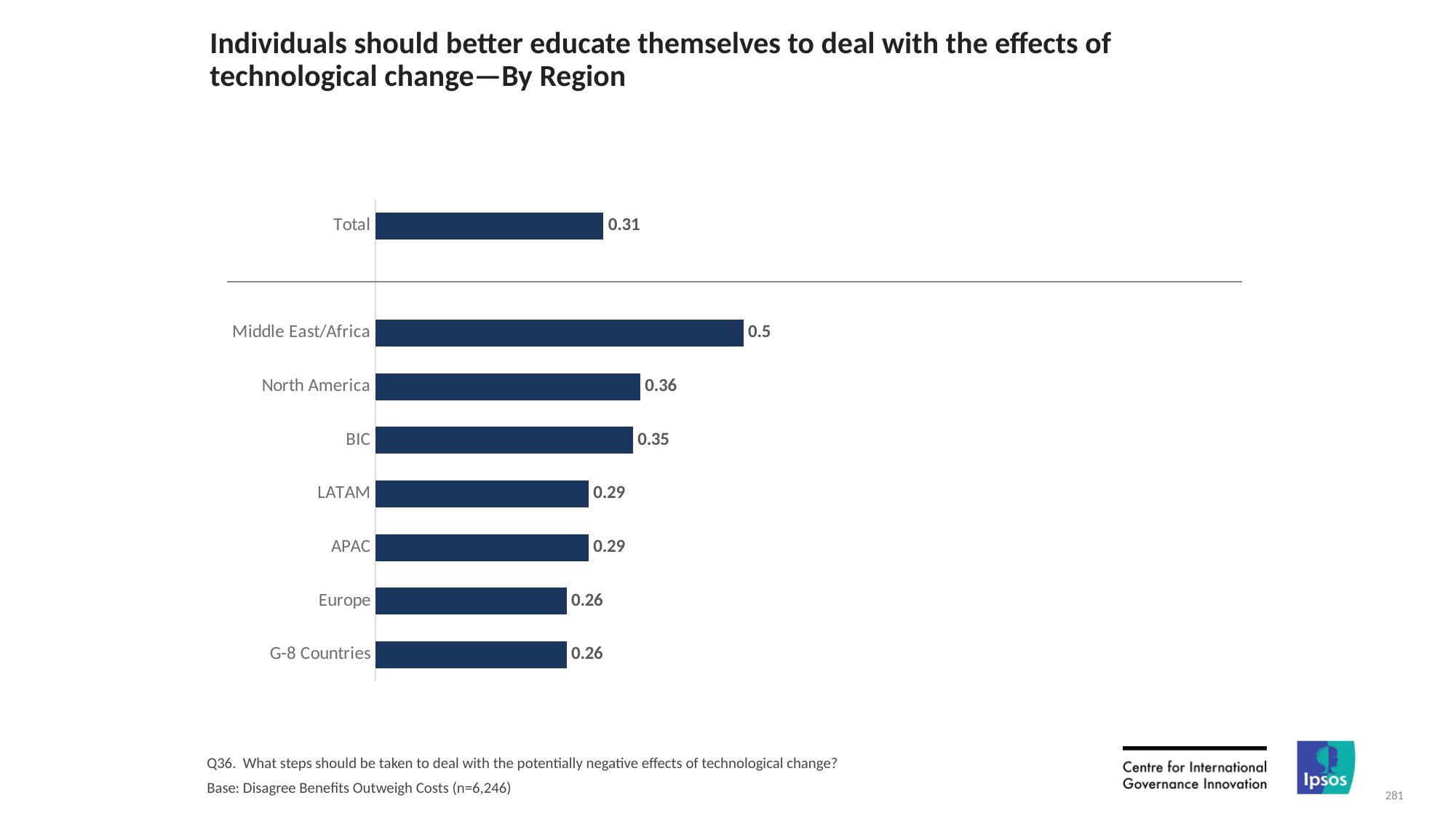
What is the value for Total? 0.31 What is the value for Europe? 0.26 What kind of chart is shown on the slide? Bar chart What is the value for Middle East/Africa? 0.5 What is the title of the chart? Individuals should better educate themselves to deal with the effects of technological change—By Region How many bars are plotted on the chart, including Total? 8 What is the value for North America? 0.36 What is the difference between the values for BIC and G-8 Countries? 0.09 Which is larger, the value for North America or the value for LATAM? North America What is the difference between the values for Middle East/Africa and North America? 0.14 Which is larger, the value for Total or the value for Europe? Total Which region has the highest value? Middle East/Africa